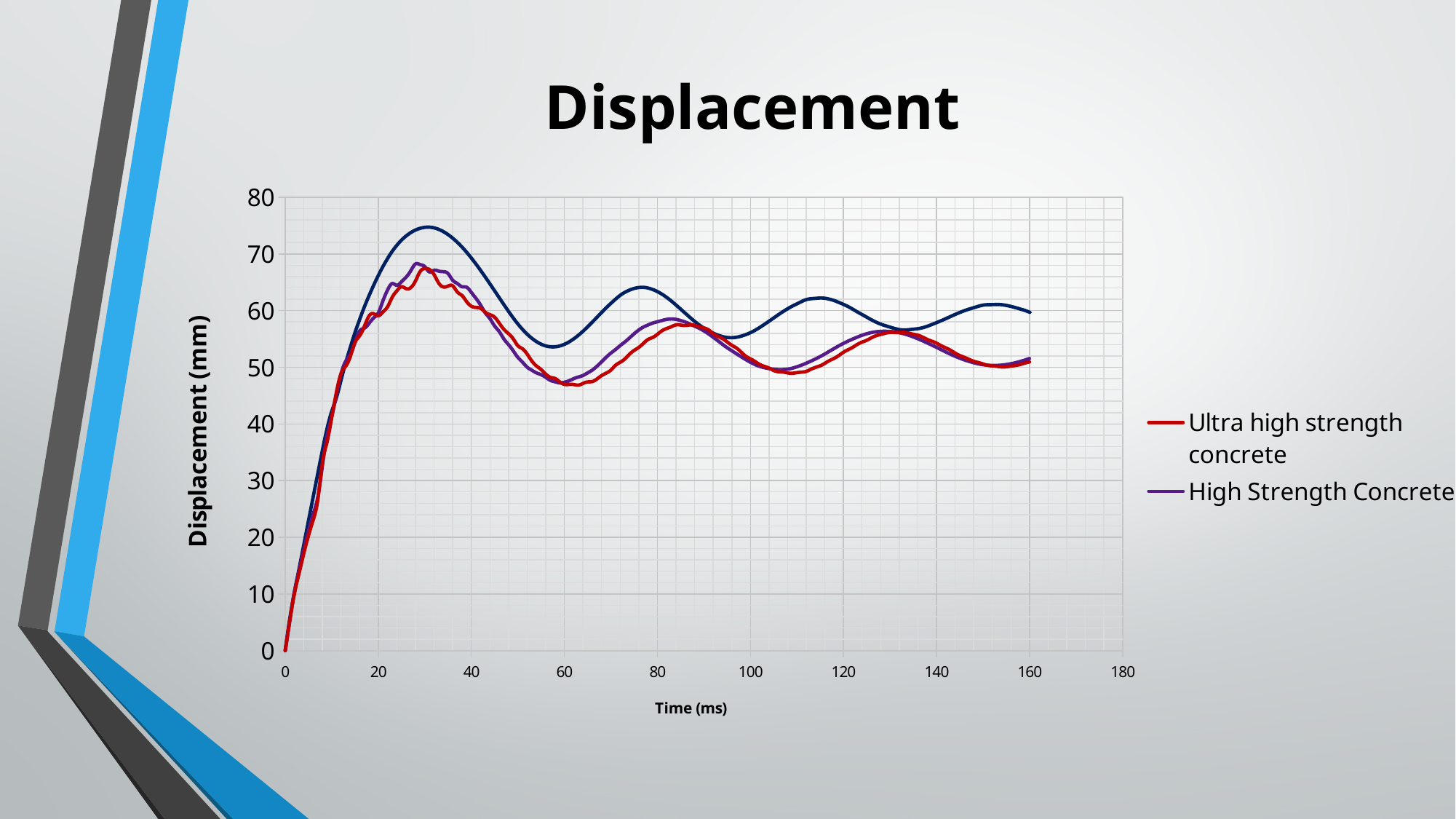
What is the highest value shown on the vertical axis? 80 Is the peak value of the Ultra high strength concrete line greater or less than 60? greater How many series does the legend list? 2 What is the label of the vertical axis? Displacement (mm) Is the value of the Ultra high strength concrete line at 60 ms greater or less than 50? less Is the peak value of the Ultra high strength concrete line greater or less than 70? less Does the High Strength Concrete line rise or fall between 30 ms and 60 ms? fall What is the title of the chart? Displacement Does the Ultra high strength concrete line rise or fall between 0 ms and 30 ms? rise What kind of chart is shown on the slide? line chart